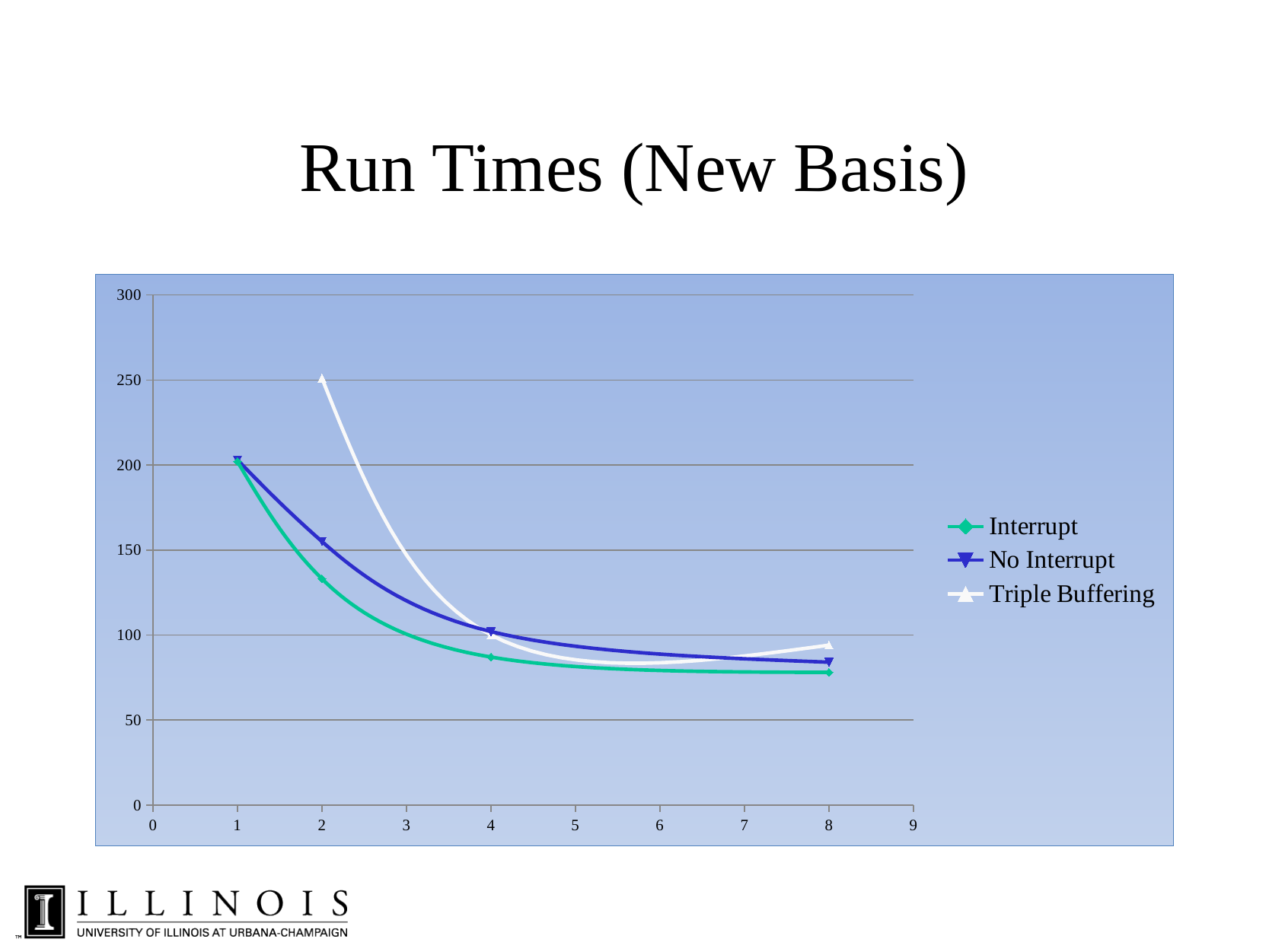
Is the value for Triple Buffering at x = 2 greater or less than 200? greater Which series has the lowest value at x = 8? Interrupt Which series is drawn in green? Interrupt Is the value for Interrupt at x = 2 greater or less than 150? less At x = 2, which is larger: the Interrupt value or the No Interrupt value? No Interrupt Which series has the highest value at x = 2? Triple Buffering Is the value for Interrupt at x = 8 greater or less than 100? less Does the Interrupt series rise or fall as the x value increases from 1 to 8? fall What is the title of the chart? Run Times (New Basis) What kind of chart is shown on the slide? line chart How many series does the legend list? 3